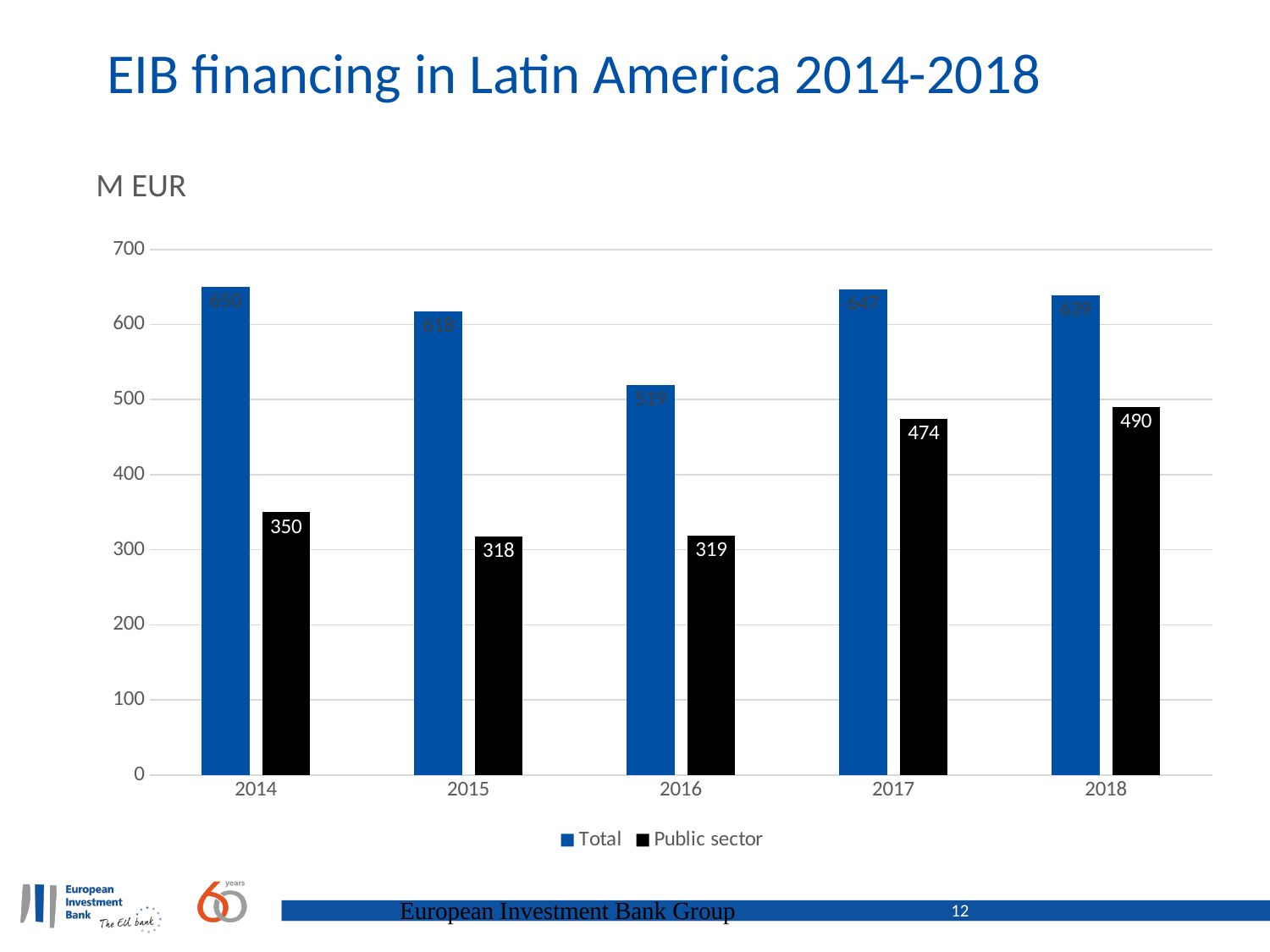
What is the Public sector value for 2014? 350 How many years are shown on the x axis? 5 Which year has the lowest Public sector value? 2015 What is the Public sector value for 2015? 318 Is the Public sector value for 2017 larger than the Public sector value for 2016? Yes Which year has the highest Public sector value? 2018 How many series does the legend list? 2 Is the Total value for 2016 greater or less than 600? less What is the difference between the Public sector values for 2018 and 2017? 16 Which year has the lowest Total value? 2016 What is the Public sector value for 2018? 490 What kind of chart is shown on the slide? Bar chart